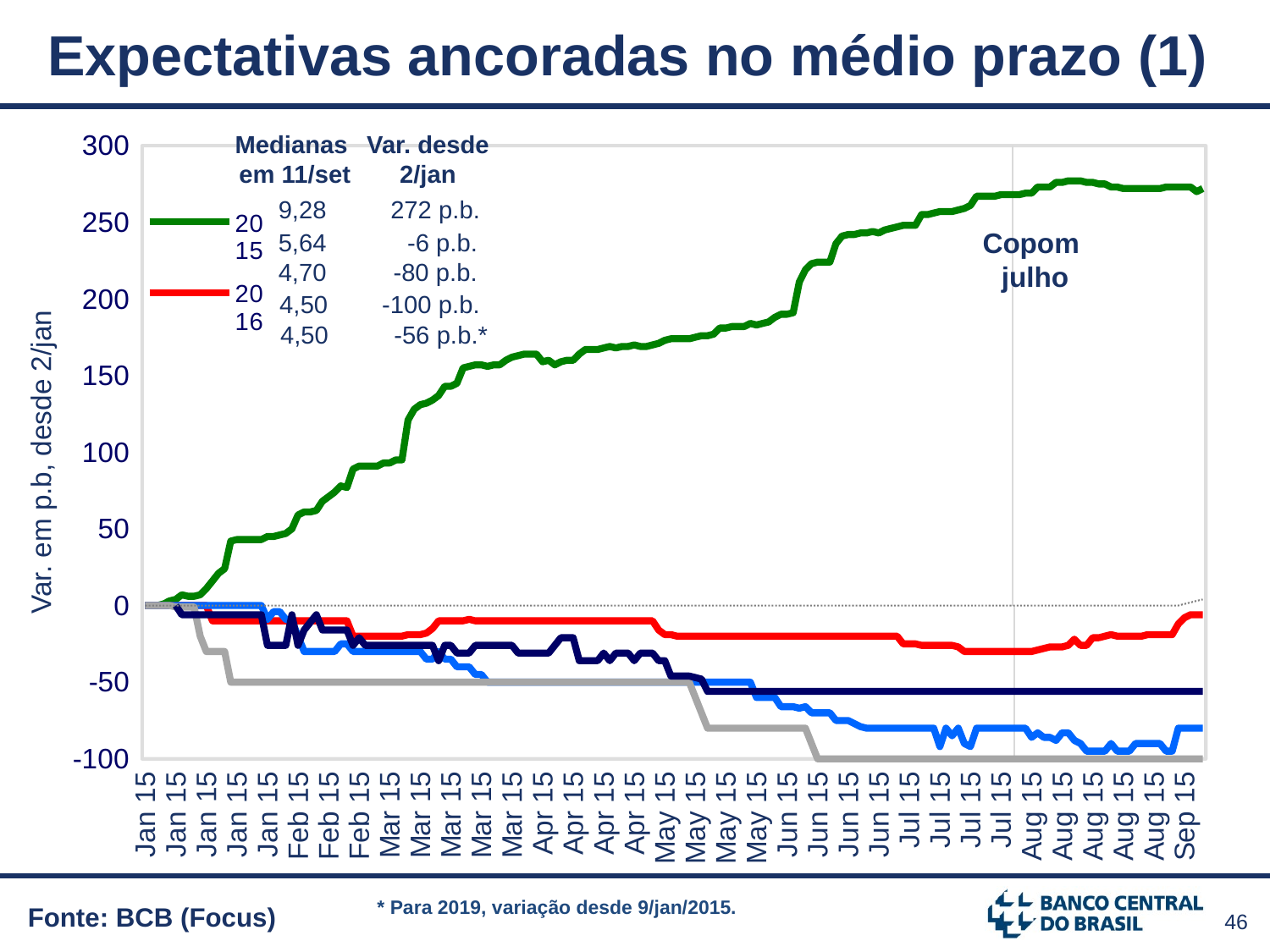
According to the table on the chart, what is the variation since 2/jan for 2016? -6 p.b. According to the table on the chart, what is the median for 2015 on 11/set? 9,28 Which series has the highest variation since 2/jan in the table, 2015 or 2016? 2015 Is the value of the green 2015 line at Sep 15 greater or less than 250? greater According to the table on the chart, what is the variation since 2/jan for 2015? 272 p.b. What kind of chart is shown on the slide? line chart Does the green 2015 line generally rise or fall from Jan 15 to Sep 15? rise Is the value of the green 2015 line at Jul 15 greater or less than 200? greater What is the label of the vertical axis? Var. em p.b, desde 2/jan Is the value of the red 2016 line at Sep 15 greater or less than 0? less According to the table on the chart, what is the median for 2016 on 11/set? 5,64 What annotation is written near the vertical line in the right part of the chart? Copom julho